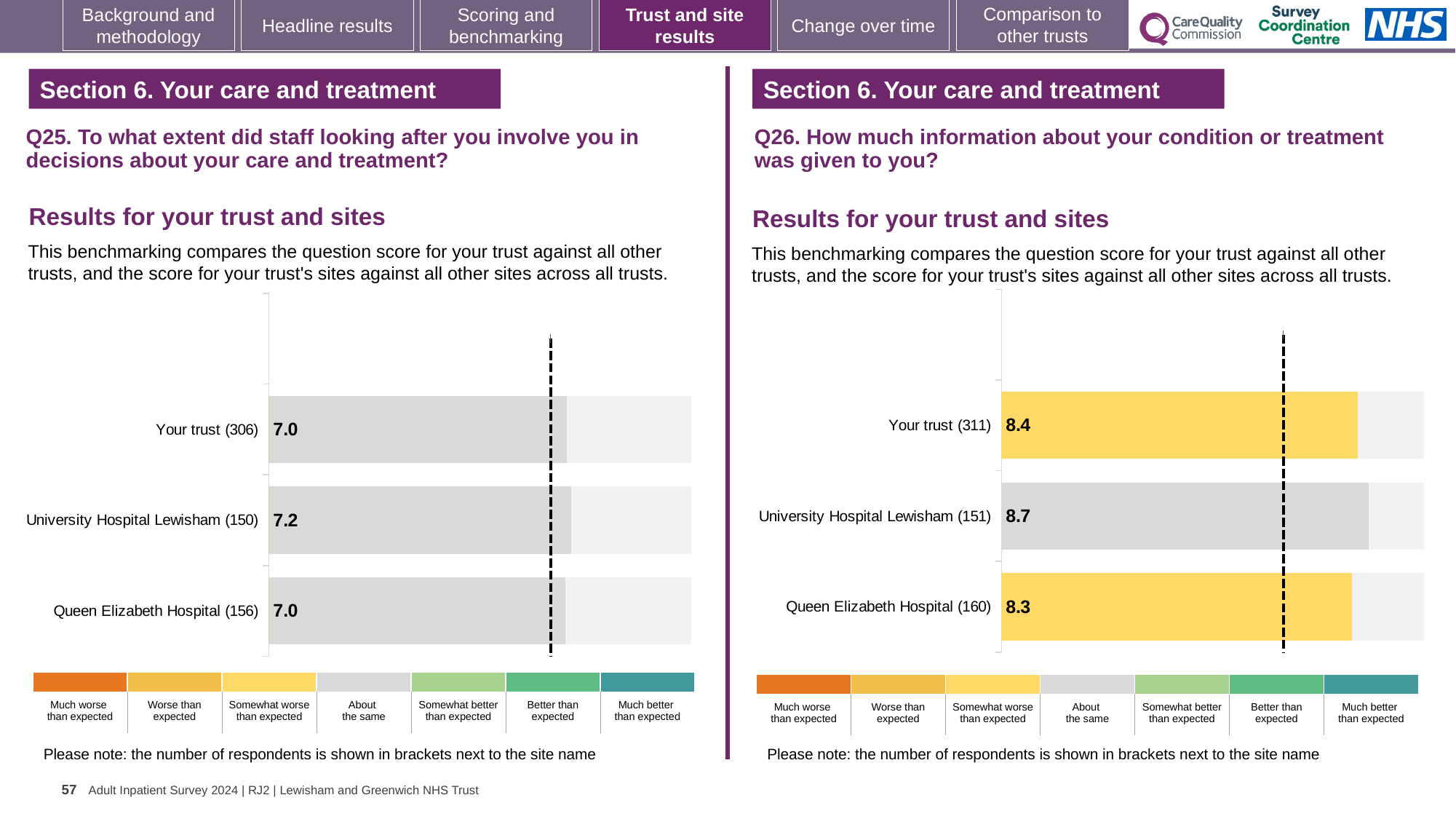
In the Q25 chart on the left, how many respondents are shown for Queen Elizabeth Hospital? 156 In the Q25 chart on the left, how many bars are plotted? 3 In the Q25 chart on the left, what is the score for Your trust? 7.0 What type of chart is used on the right for Q26? Bar chart In the Q26 chart on the right, which has the larger score, Your trust or University Hospital Lewisham? University Hospital Lewisham In the Q26 chart on the right, what is the score for Your trust? 8.4 In the Q26 chart on the right, which site or trust has the lowest score? Queen Elizabeth Hospital In the Q26 chart on the right, what is the difference between the scores for University Hospital Lewisham and Queen Elizabeth Hospital? 0.4 In the Q25 chart on the left, what is the score for University Hospital Lewisham? 7.2 In the Q26 chart on the right, how many respondents are shown for Your trust? 311 In the Q26 chart on the right, what is the score for Queen Elizabeth Hospital? 8.3 In the Q25 chart on the left, which site or trust has the highest score? University Hospital Lewisham